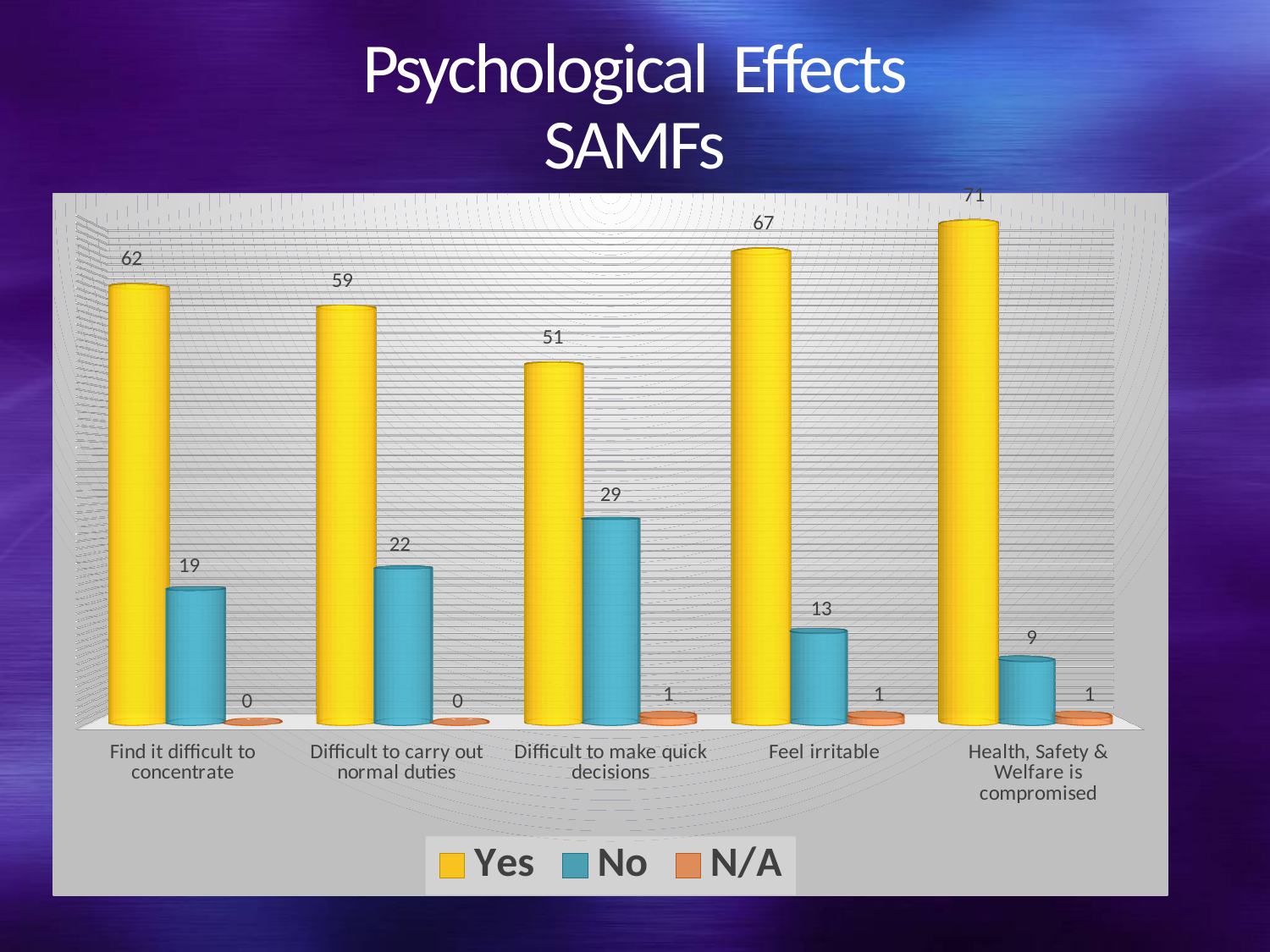
Which colour represents the 'No' series in the legend? Blue Which category has the lowest 'No' value? Health, Safety & Welfare is compromised Which category has the highest 'Yes' value? Health, Safety & Welfare is compromised What is the 'N/A' value for 'Find it difficult to concentrate'? 0 What is the title of the chart? Psychological Effects SAMFs Which is larger: the 'No' value for 'Find it difficult to concentrate' or the 'No' value for 'Feel irritable'? Find it difficult to concentrate What is the 'Yes' value for 'Feel irritable'? 67 How many categories are shown on the x axis? 5 What is the difference between the 'Yes' and 'No' values for 'Difficult to carry out normal duties'? 37 How many series does the legend list? 3 What is the 'No' value for 'Difficult to make quick decisions'? 29 What kind of chart is shown on the slide? Bar chart